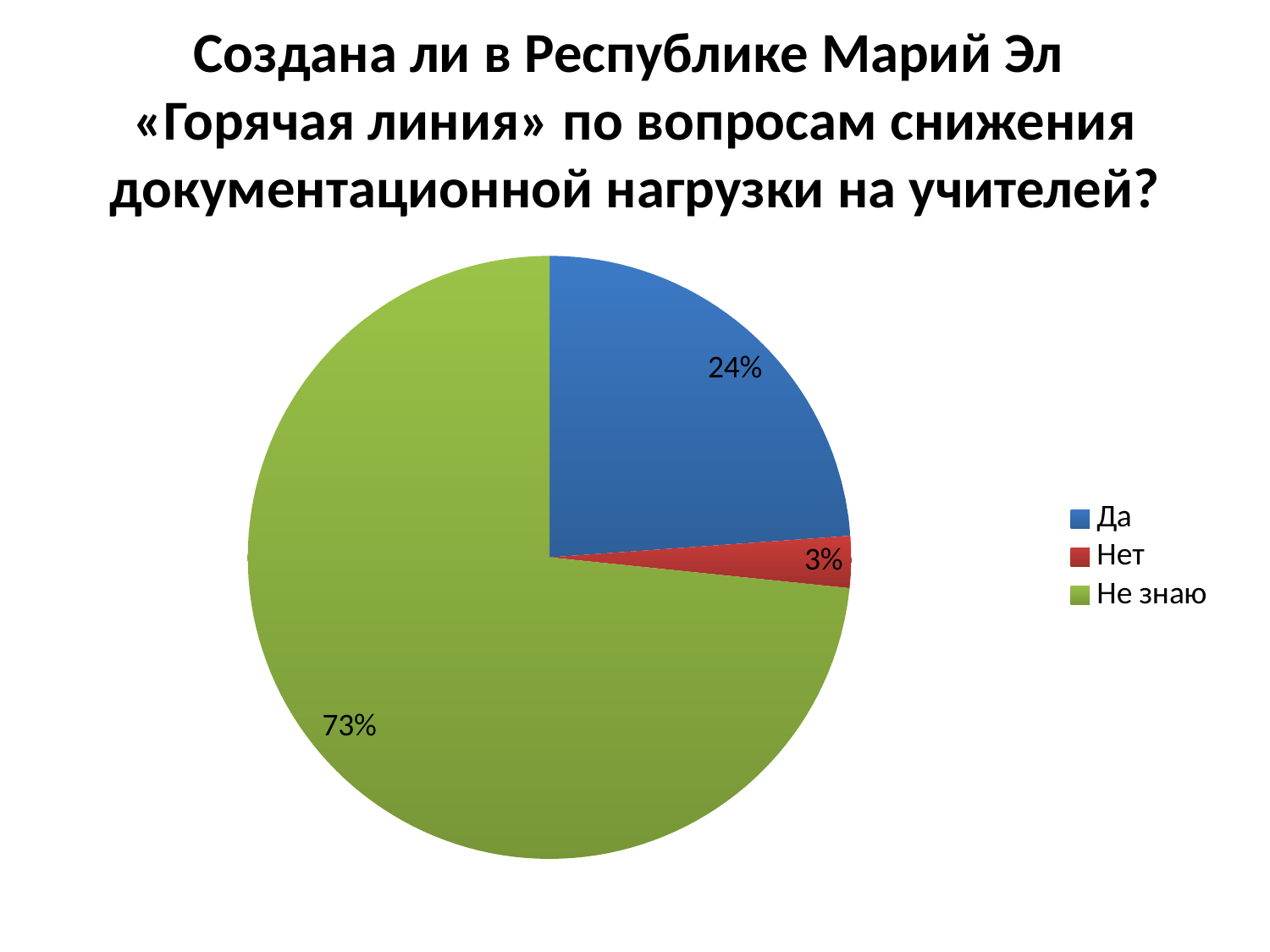
Which category has the smallest slice of the pie? Нет What share of the pie does "Не знаю" represent? 73% What is the difference between the shares for "Не знаю" and "Да"? 49% What share of the pie does "Да" represent? 24% Which category has the largest slice of the pie? Не знаю Which is larger, the share for "Да" or the share for "Нет"? Да What colour is the slice for "Не знаю"? Green What kind of chart is shown on the slide? Pie chart What colour is the slice for "Да"? Blue What is the difference between the shares for "Да" and "Нет"? 21% What share of the pie does "Нет" represent? 3% How many categories does the pie chart show? 3